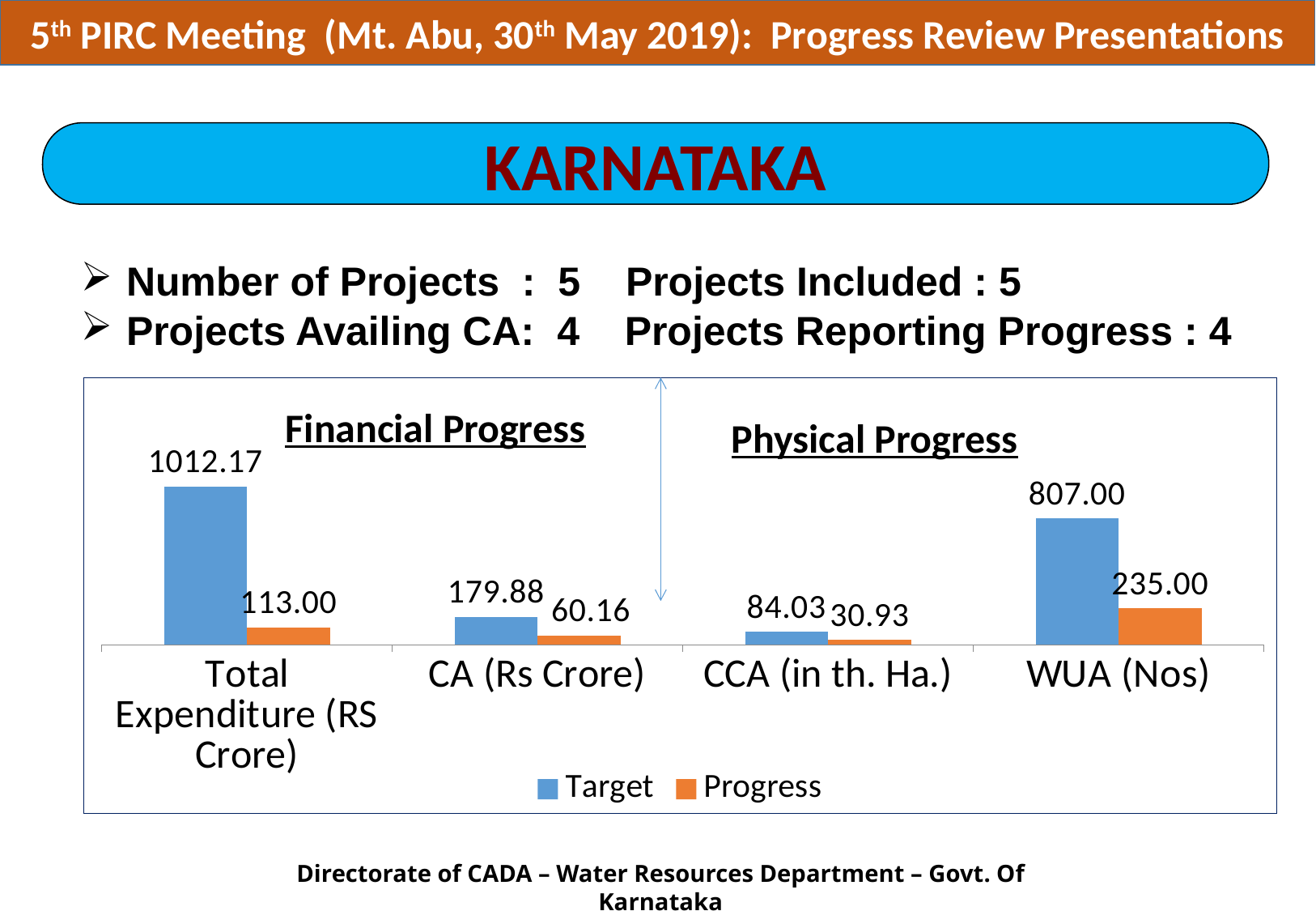
How many series does the chart legend list? 2 What is the difference between the Target and Progress values for WUA (Nos)? 572.00 What is the Progress value for WUA (Nos)? 235.00 Which category has the lowest Progress value? CCA (in th. Ha.) Which colour represents the Progress series in the chart? Orange Which category has the highest Target value? Total Expenditure (RS Crore) What kind of chart is shown on the slide? Bar chart What is the Target value for CCA (in th. Ha.)? 84.03 Which is larger: the Progress value for Total Expenditure (RS Crore) or the Progress value for WUA (Nos)? WUA (Nos) What is the Target value for Total Expenditure (RS Crore)? 1012.17 How many categories are shown on the x axis of the chart? 4 What is the Progress value for CA (Rs Crore)? 60.16